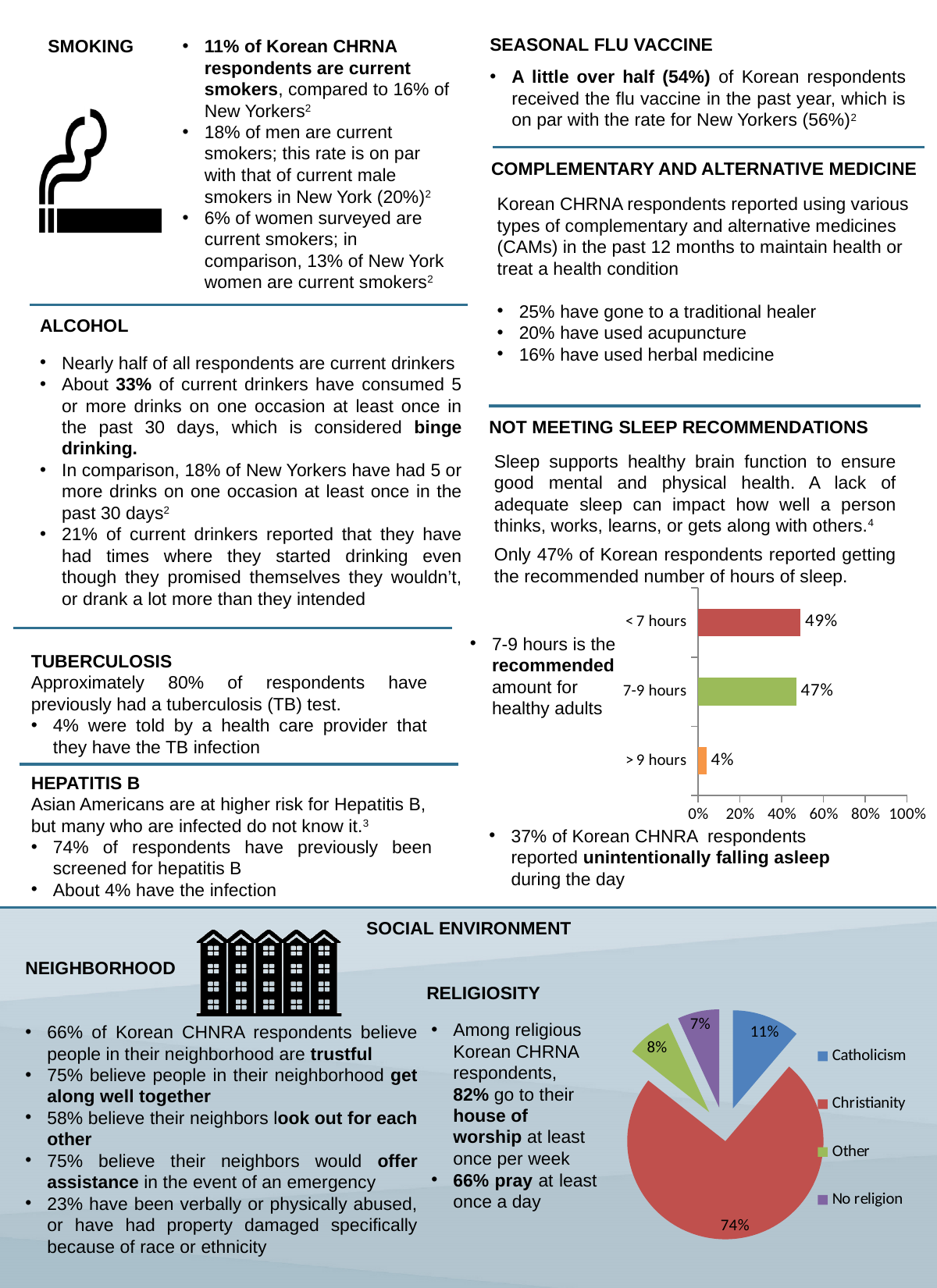
In the religion pie chart, how many categories does the legend list? 4 In the religion pie chart, which slice is the largest? Christianity In the religion pie chart, what share is Christianity? 74% In the religion pie chart, what colour is the No religion slice? Purple In the sleep hours bar chart, which category has the lowest value? > 9 hours In the sleep hours bar chart, what is the difference between the < 7 hours and > 9 hours values? 45% In the sleep hours bar chart, what percentage of respondents sleep less than 7 hours? 49% In the religion pie chart, which is larger, Catholicism or Other? Catholicism In the sleep hours bar chart, what is the value for 7-9 hours? 47% What type of chart is used to show the sleep hours data? Bar chart In the sleep hours bar chart, is the value for > 9 hours greater or less than 20%? less In the sleep hours bar chart, how many categories are shown? 3